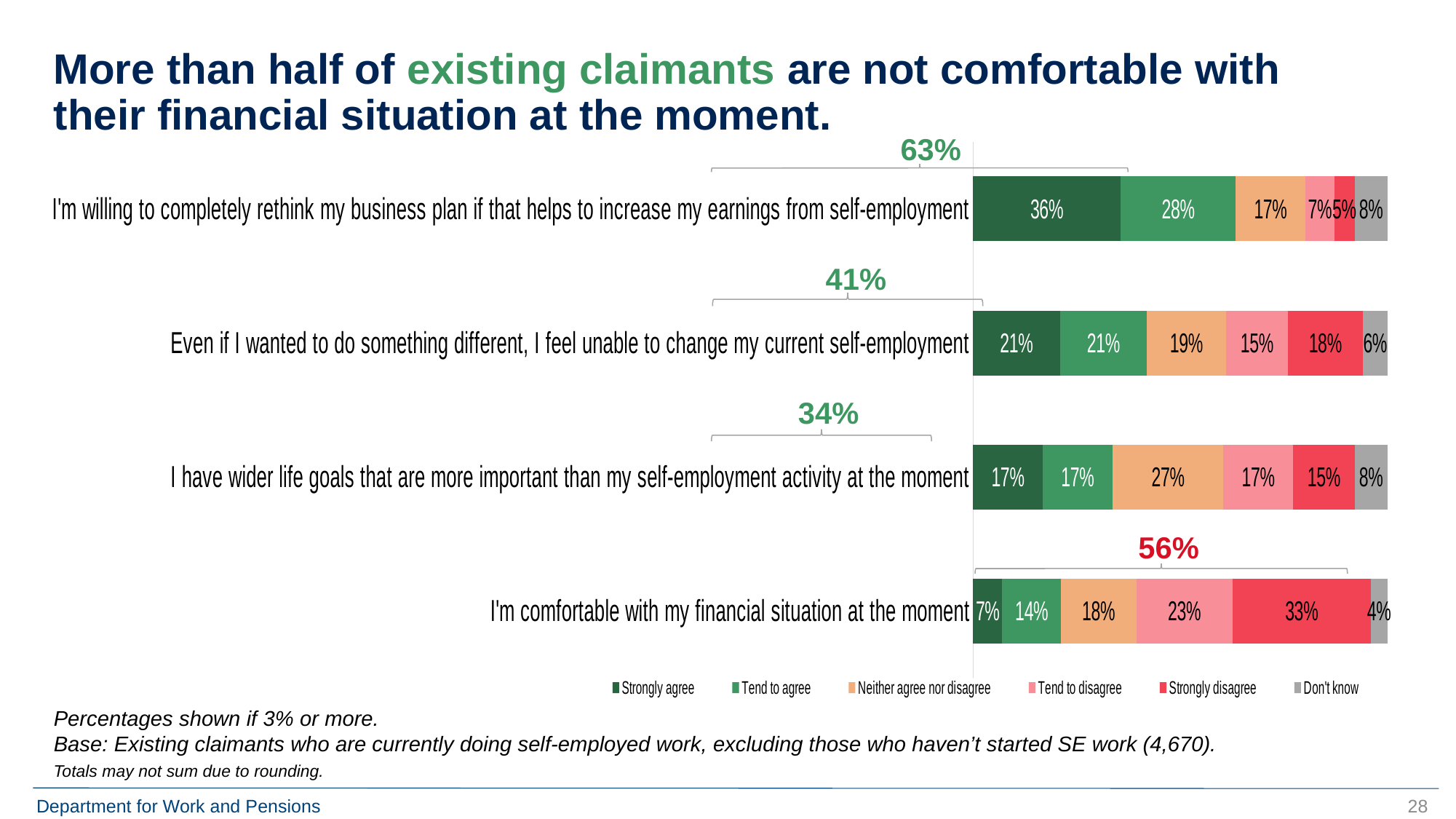
Which statement has a larger "Tend to agree" share: "I'm willing to completely rethink my business plan..." or "Even if I wanted to do something different, I feel unable to change my current self-employment"? I'm willing to completely rethink my business plan if that helps to increase my earnings from self-employment What type of chart is shown on the slide? Stacked bar chart How many response categories does the legend list? 6 What percentage strongly disagree with "I'm comfortable with my financial situation at the moment"? 33% Which statement has the lowest "Don't know" percentage? I'm comfortable with my financial situation at the moment What is the "Tend to disagree" value for "Even if I wanted to do something different, I feel unable to change my current self-employment"? 15% Which statement has the highest "Strongly agree" percentage? I'm willing to completely rethink my business plan if that helps to increase my earnings from self-employment What percentage of existing claimants strongly agree with the statement "I'm comfortable with my financial situation at the moment"? 7% How many statements are shown in the chart? 4 How many percentage points higher is "Strongly disagree" for "I'm comfortable with my financial situation at the moment" than for "I have wider life goals that are more important than my self-employment activity at the moment"? 18 percentage points What is the "Neither agree nor disagree" value for "I have wider life goals that are more important than my self-employment activity at the moment"? 27% What combined percentage is shown above the bar for "I'm willing to completely rethink my business plan if that helps to increase my earnings from self-employment"? 63%